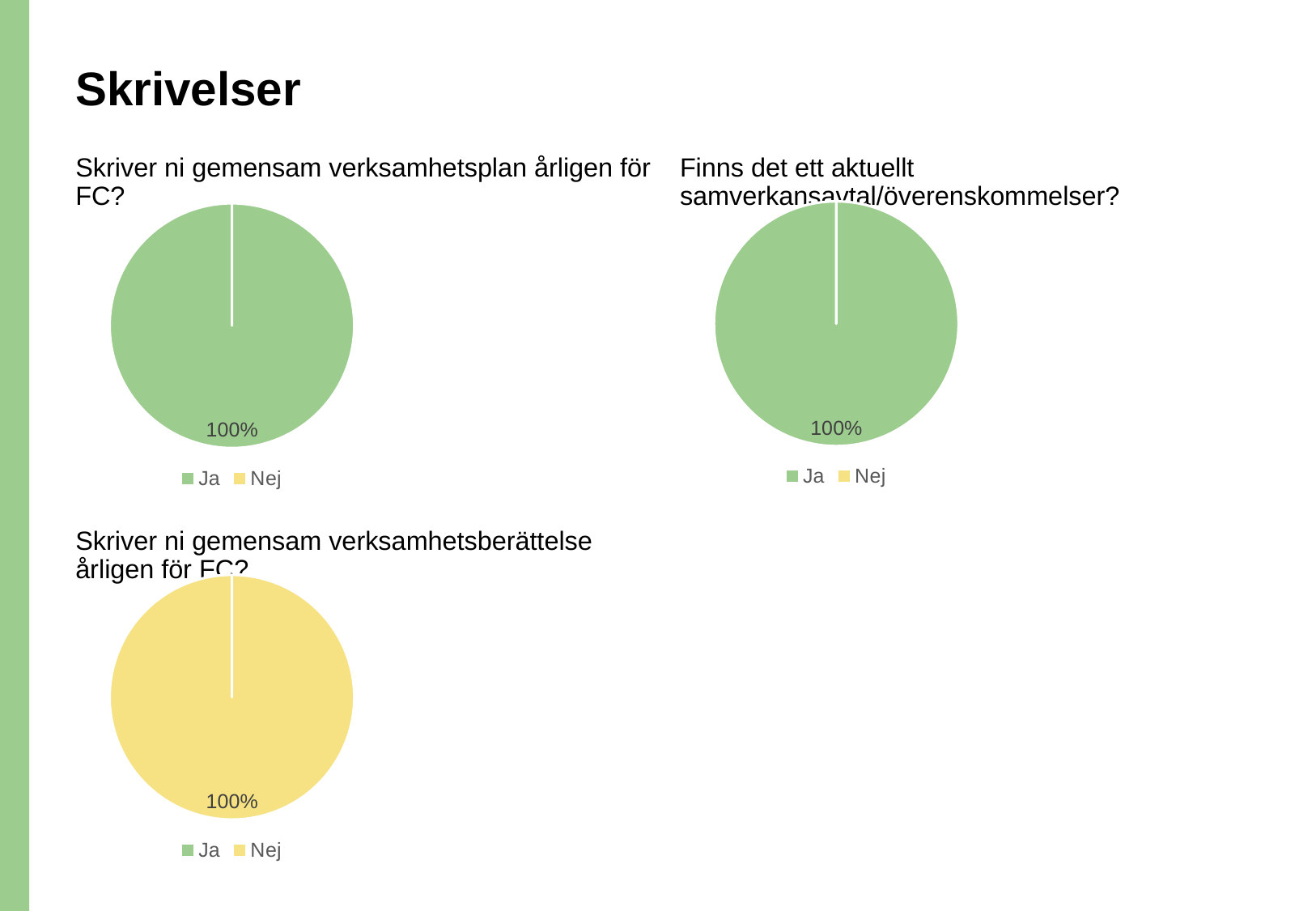
How many entries does the legend list in the chart titled "Skriver ni gemensam verksamhetsplan årligen för FC?"? 2 What colour represents "Nej" in the legend of the bottom-left chart? Yellow How many pie charts are shown on the slide? 3 In the chart titled "Skriver ni gemensam verksamhetsberättelse årligen för FC?", what share of the pie does "Nej" take? 100% In the chart titled "Finns det ett aktuellt samverkansavtal/överenskommelser?", which category is the largest? Ja In the chart titled "Skriver ni gemensam verksamhetsplan årligen för FC?", which is larger, Ja or Nej? Ja In the chart titled "Skriver ni gemensam verksamhetsberättelse årligen för FC?", which is larger, Ja or Nej? Nej In the chart titled "Finns det ett aktuellt samverkansavtal/överenskommelser?", what share of the pie does "Ja" take? 100% In the chart titled "Skriver ni gemensam verksamhetsplan årligen för FC?", what share of the pie does "Ja" take? 100% What kind of chart is the top-left chart on the slide? Pie chart What is the title of the slide? Skrivelser In the chart titled "Skriver ni gemensam verksamhetsberättelse årligen för FC?", which category is the largest? Nej